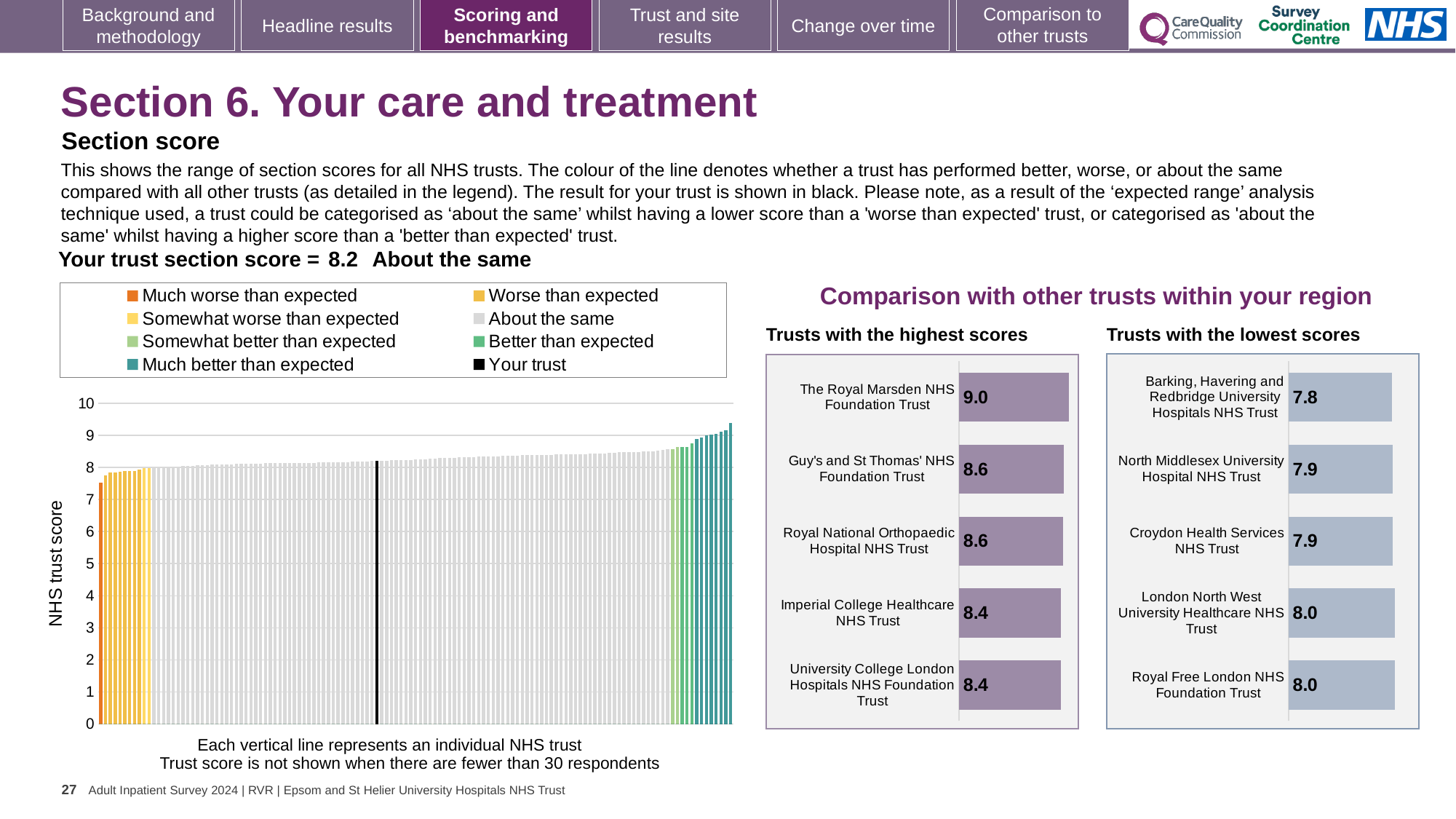
In the 'Trusts with the highest scores' chart, what is the score for Imperial College Healthcare NHS Trust? 8.4 In the 'Trusts with the highest scores' chart, what is the score for The Royal Marsden NHS Foundation Trust? 9.0 In the large chart on the left, how many entries does the legend list? 8 In the 'Trusts with the highest scores' chart, what is the difference between the scores of The Royal Marsden NHS Foundation Trust and Imperial College Healthcare NHS Trust? 0.6 In the 'Trusts with the lowest scores' chart, how many trusts are shown? 5 In the 'Trusts with the lowest scores' chart, what is the score for Barking, Havering and Redbridge University Hospitals NHS Trust? 7.8 In the large chart on the left, is the value of the tallest bar greater or less than 9? greater In the large chart on the left, what is the label of the vertical axis? NHS trust score In the 'Trusts with the highest scores' chart, which trust has the highest score? The Royal Marsden NHS Foundation Trust In the 'Trusts with the lowest scores' chart, which trust has the lowest score? Barking, Havering and Redbridge University Hospitals NHS Trust In the 'Trusts with the lowest scores' chart, what is the score for Royal Free London NHS Foundation Trust? 8.0 What kind of chart is the large chart on the left showing NHS trust scores? Bar chart